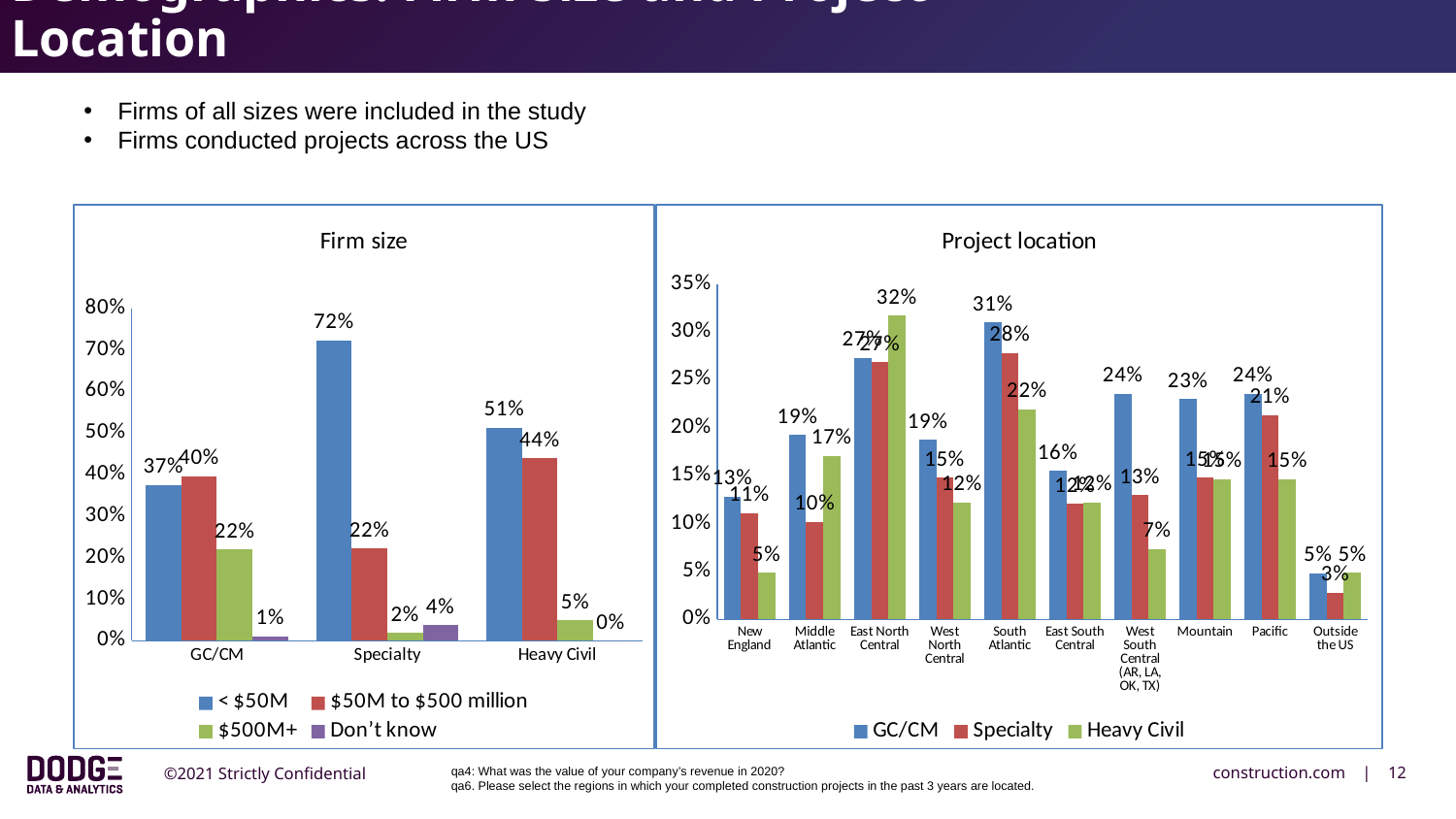
In the Firm size chart, which firm type has the highest value in the < $50M series? Specialty In the Project location chart, what is the difference between the GC/CM and Heavy Civil values for West South Central? 17% In the Firm size chart, what is the difference between the < $50M and $500M+ values for GC/CM? 15% In the Firm size chart, which is larger for GC/CM: the < $50M value or the $50M to $500 million value? $50M to $500 million In the Project location chart, how many regions are shown on the x axis? 10 In the Firm size chart, what is the value for Heavy Civil in the $50M to $500 million series? 44% What type of chart is the Project location chart? Bar chart In the Project location chart, what is the Specialty value for Pacific? 21% In the Firm size chart, how many series does the legend list? 4 In the Project location chart, which region has the highest GC/CM value? South Atlantic In the Project location chart, what is the Heavy Civil value for East North Central? 32% In the Firm size chart, what percentage of Specialty firms have revenue under $50M? 72%